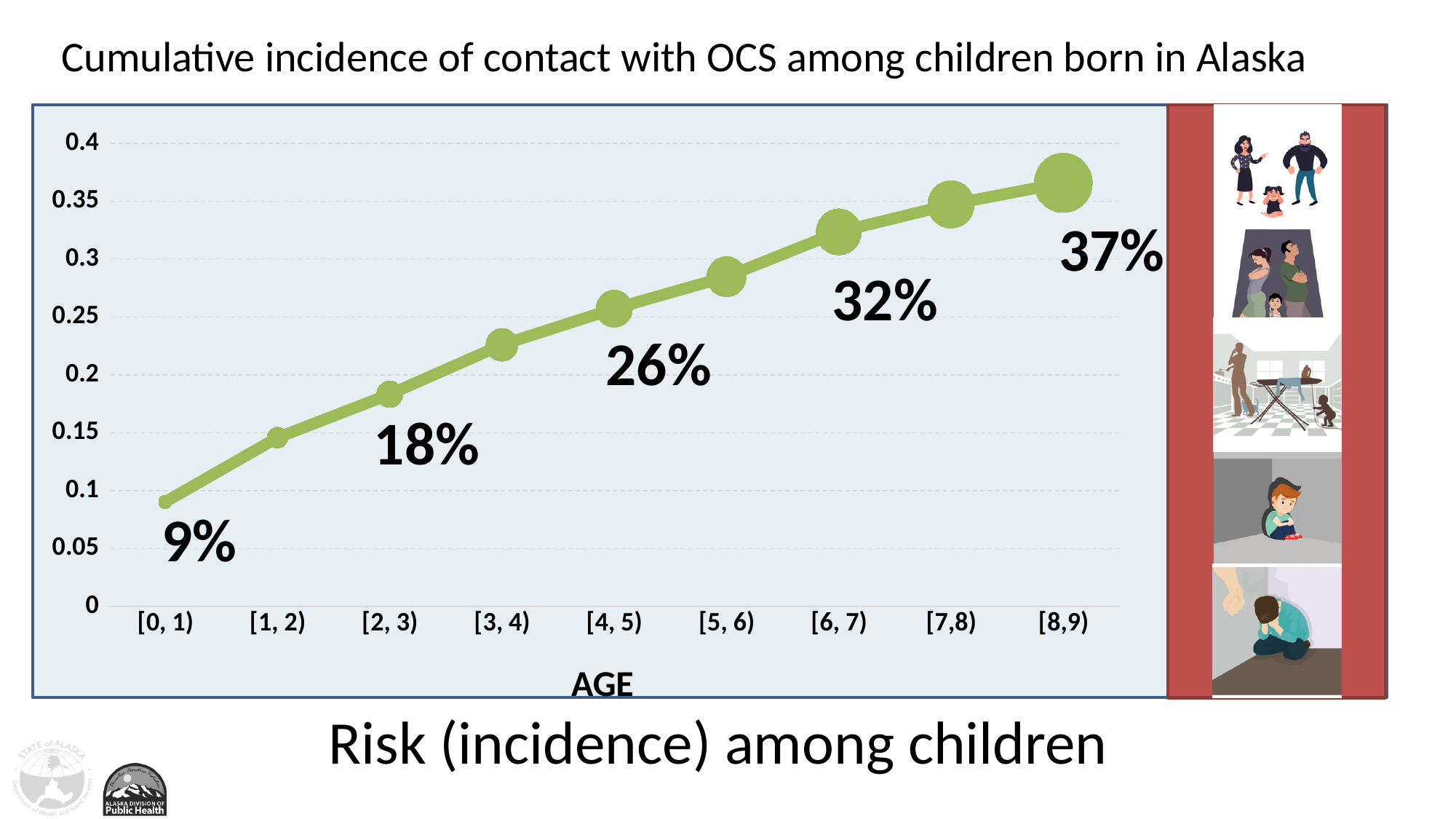
What is the cumulative incidence value labelled for the [0, 1) age group? 9% What is the cumulative incidence value labelled for the [2, 3) age group? 18% Is the value for the [7,8) age group greater or less than 0.3? greater What is the cumulative incidence value labelled for the [8,9) age group? 37% Which age group has the lowest cumulative incidence? [0, 1) By how many percentage points does the labelled value for [8,9) exceed the labelled value for [0, 1)? 28 percentage points Is the value for the [3, 4) age group greater or less than 0.2? greater How many age groups are plotted on the x axis? 9 What is the cumulative incidence value labelled for the [6, 7) age group? 32% Which age group has the highest cumulative incidence? [8,9) What is the cumulative incidence value labelled for the [4, 5) age group? 26% Does the cumulative incidence rise or fall as age increases? rises